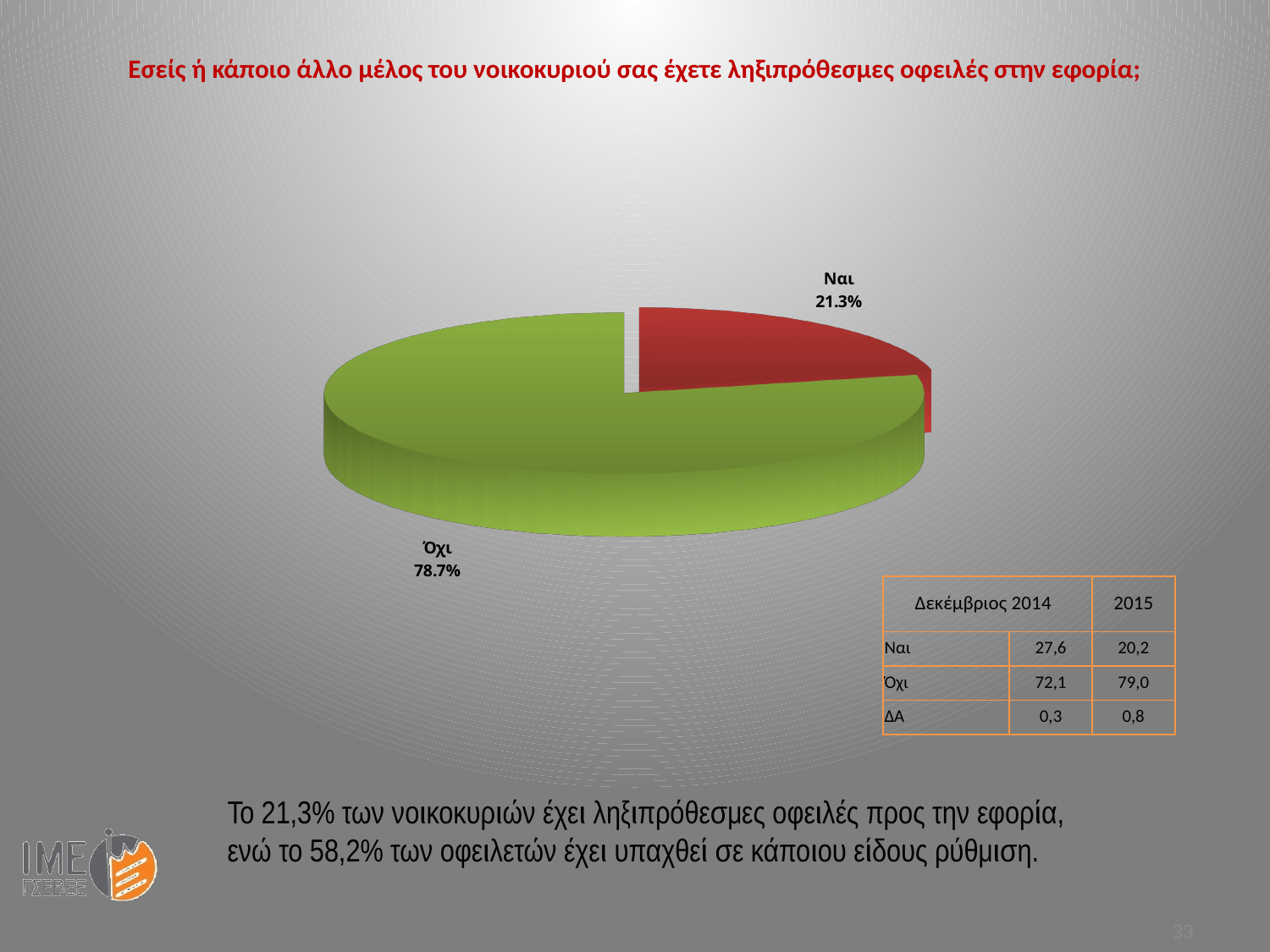
What colour is the "Όχι" slice in the pie chart? Green Which slice of the pie chart is the largest? Όχι Which slice of the pie chart is the smallest? Ναι Which is larger in the pie chart, "Ναι" or "Όχι"? Όχι What colour is the "Ναι" slice in the pie chart? Red How many slices does the pie chart have? 2 What percentage of the pie chart is the "Ναι" slice? 21.3% What share of the pie does the "Ναι" slice represent? 21.3% What type of chart is shown on the slide? Pie chart What percentage of the pie chart is the "Όχι" slice? 78.7% By how many percentage points does the "Όχι" slice exceed the "Ναι" slice? 57.4